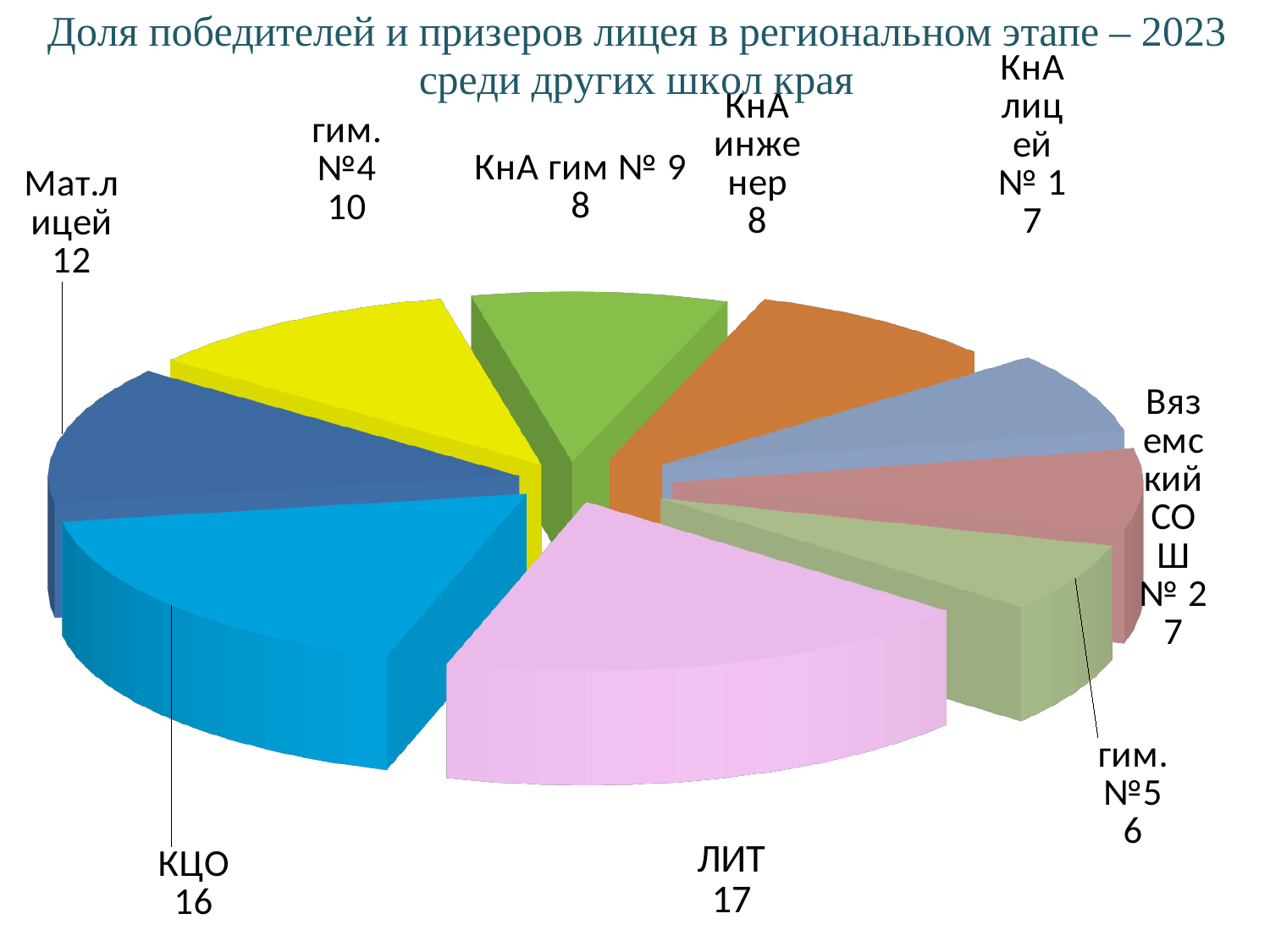
What is the value shown for Мат.лицей? 12 What is the difference between the values for ЛИТ and КЦО? 1 Which category has the largest slice in the pie chart? ЛИТ Which category has the smallest slice in the pie chart? гим. №5 What is the value shown for КнА лицей № 1? 7 What is the value shown for ЛИТ? 17 Which is larger, the value for Мат.лицей or the value for гим. №5? Мат.лицей What kind of chart is shown on the slide? pie chart What is the value shown for гим. №4? 10 What is the value shown for КЦО? 16 What is the title of the chart? Доля победителей и призеров лицея в региональном этапе – 2023 среди других школ края How many slices does the pie chart have? 9